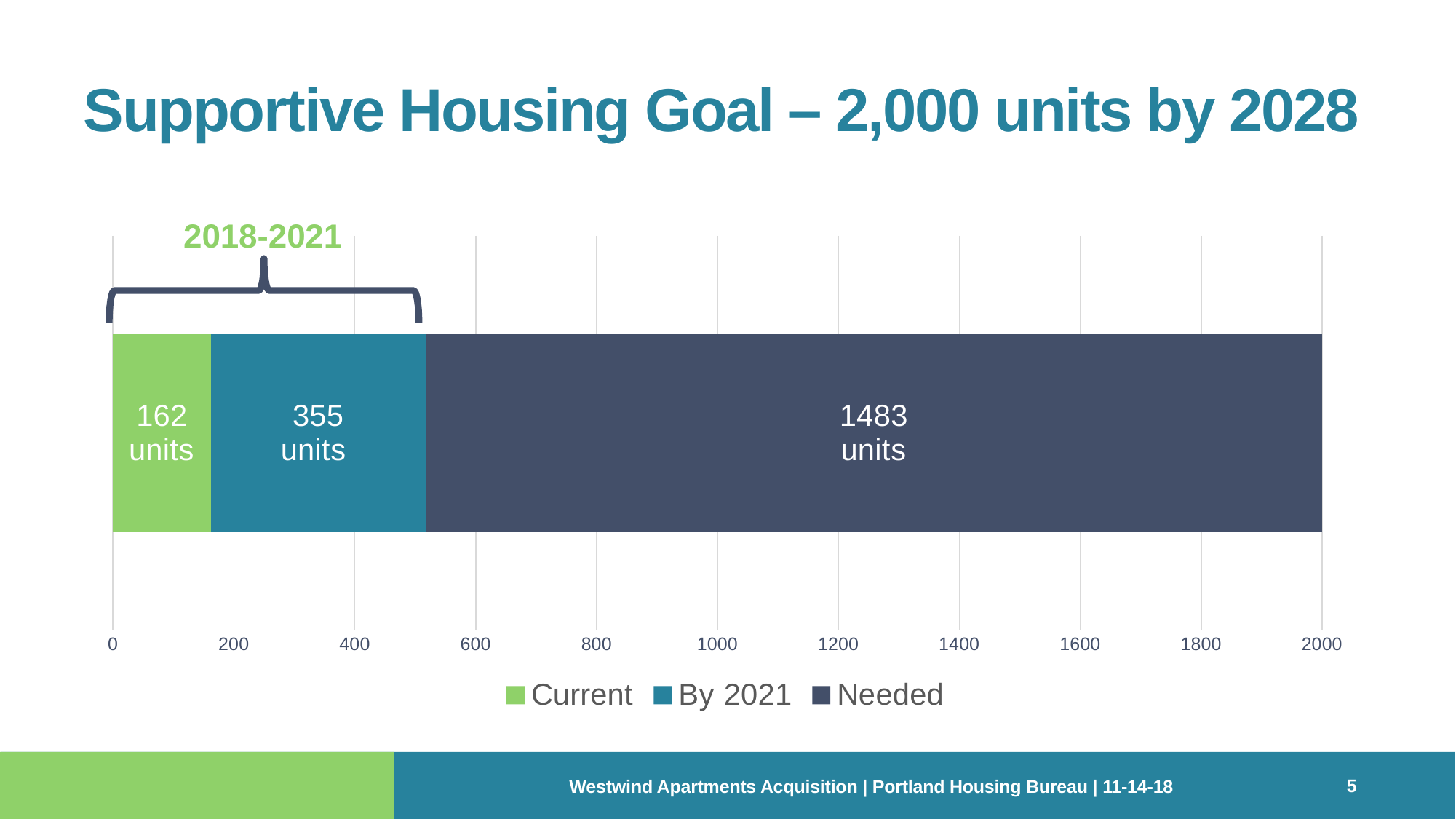
How many series does the legend list? 3 What is the difference between the By 2021 value and the Current value? 193 units Which series has the smallest segment in the bar? Current What is the total of all three segments of the stacked bar? 2000 units What period does the bracket above the first two segments label? 2018-2021 What is the highest value shown on the x axis? 2000 What kind of chart is shown on the slide? Stacked bar chart What value is shown for the Current segment of the bar? 162 units Which is larger, the Needed value or the By 2021 value? Needed Which series has the largest segment in the bar? Needed What value is shown for the Needed segment of the bar? 1483 units What value is shown for the By 2021 segment of the bar? 355 units